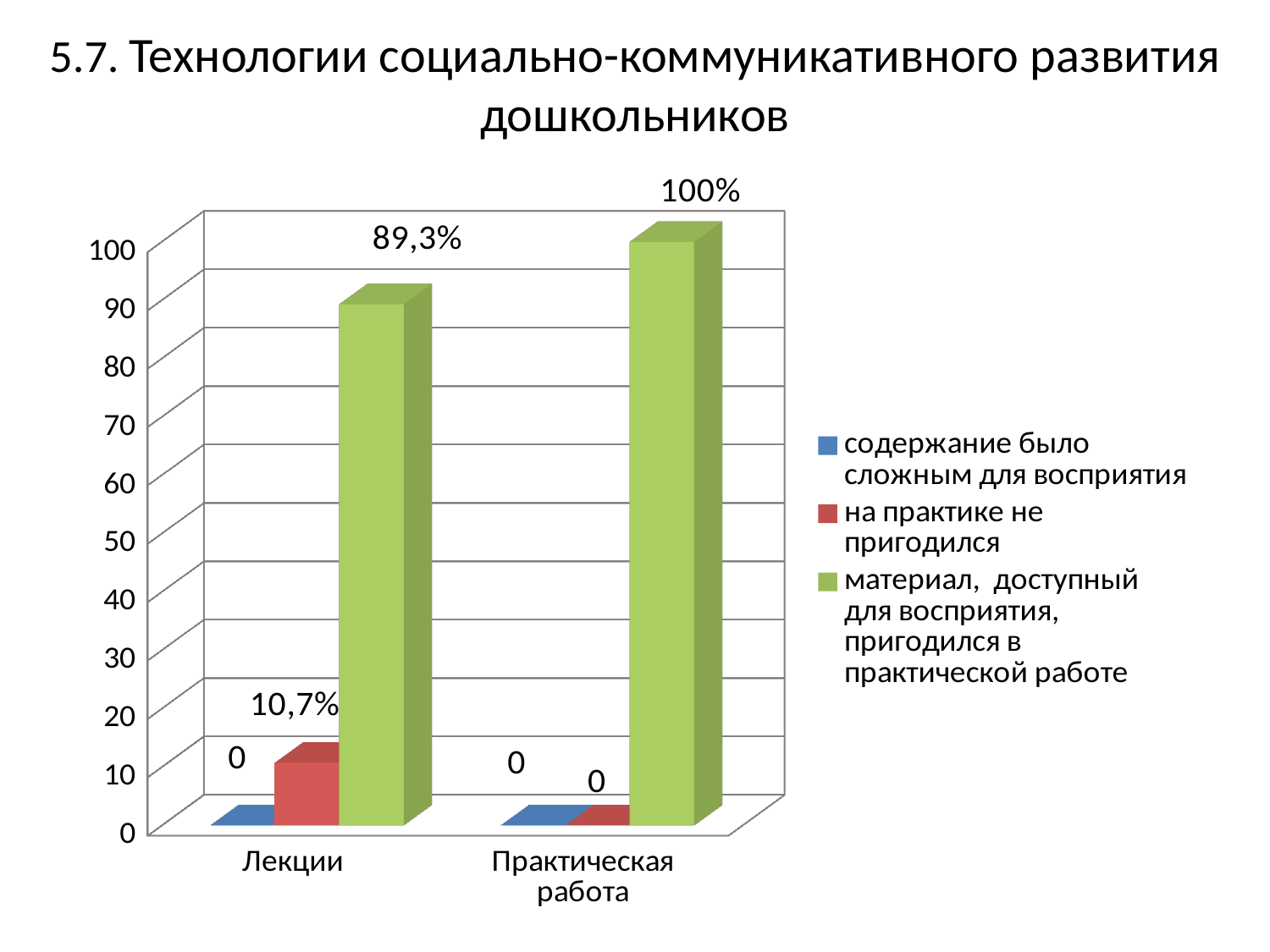
What is the value for 'на практике не пригодился' in the 'Практическая работа' category? 0 What is the value for 'материал, доступный для восприятия, пригодился в практической работе' in the 'Практическая работа' category? 100% What is the value for 'на практике не пригодился' in the 'Лекции' category? 10,7% What is the value for 'материал, доступный для восприятия, пригодился в практической работе' in the 'Лекции' category? 89,3% What colour are the bars for the series 'на практике не пригодился'? red How many categories are shown on the x axis of the chart? 2 Which category has the higher value for 'материал, доступный для восприятия, пригодился в практической работе': 'Лекции' or 'Практическая работа'? Практическая работа How many series does the legend list? 3 Is the value for 'на практике не пригодился' in the 'Лекции' category greater or less than 20? less What is the value for 'содержание было сложным для восприятия' in the 'Лекции' category? 0 Which series has the highest value in the 'Лекции' category? материал, доступный для восприятия, пригодился в практической работе What kind of chart is shown on the slide? bar chart